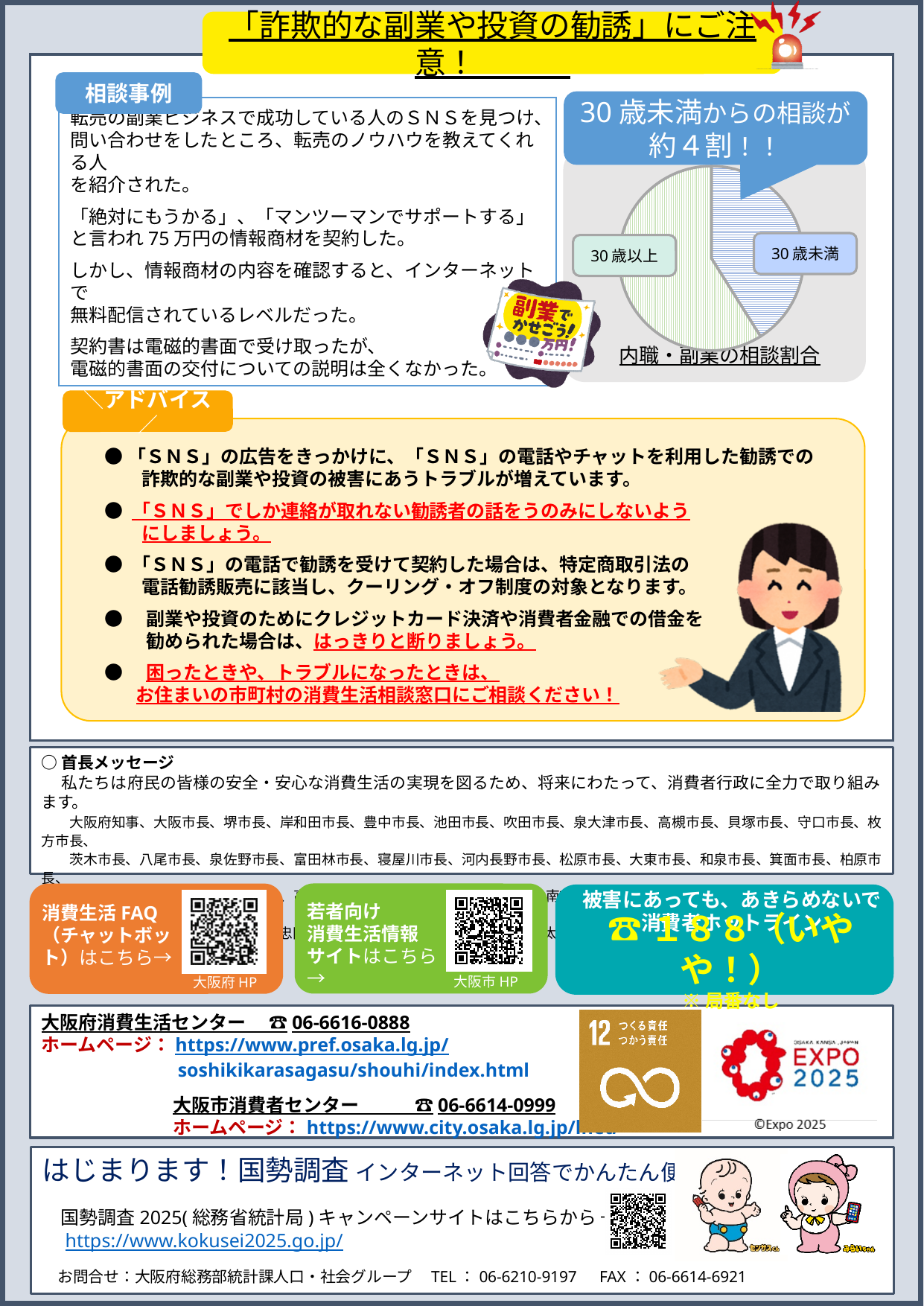
What is the title written below the pie chart on the slide? 内職・副業の相談割合 Which category takes the smallest share of the pie chart 内職・副業の相談割合? 30歳未満 Which category takes the largest share of the pie chart 内職・副業の相談割合? 30歳以上 What kind of chart is shown under the heading 内職・副業の相談割合? pie chart In the pie chart 内職・副業の相談割合, which slice is larger, 30歳以上 or 30歳未満? 30歳以上 What are the two category labels shown on the pie chart 内職・副業の相談割合? 30歳以上, 30歳未満 How many slices does the pie chart 内職・副業の相談割合 have? 2